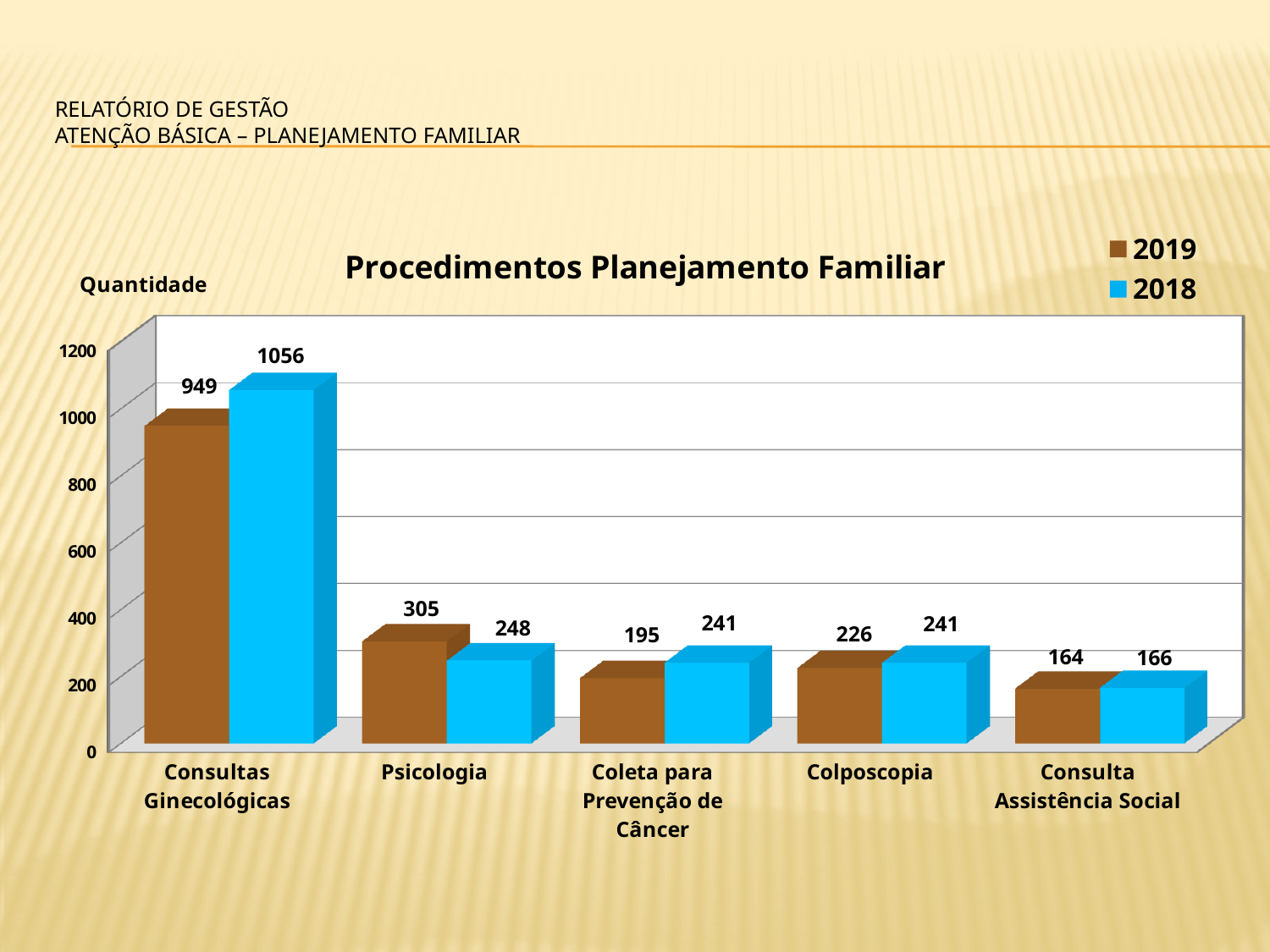
What is the difference between the 2018 and 2019 values for Consultas Ginecológicas? 107 How many series does the legend list? 2 Which is larger for Psicologia, the 2019 value or the 2018 value? 2019 What is the 2018 value for Psicologia? 248 What kind of chart is shown? Bar chart Which category has the lowest 2019 value? Consulta Assistência Social What is the 2019 value for Consultas Ginecológicas? 949 Which category has the highest 2018 value? Consultas Ginecológicas How many categories are shown on the x axis? 5 What is the 2019 value for Coleta para Prevenção de Câncer? 195 What is the title of the chart? Procedimentos Planejamento Familiar What is the difference between the 2019 and 2018 values for Colposcopia? 15